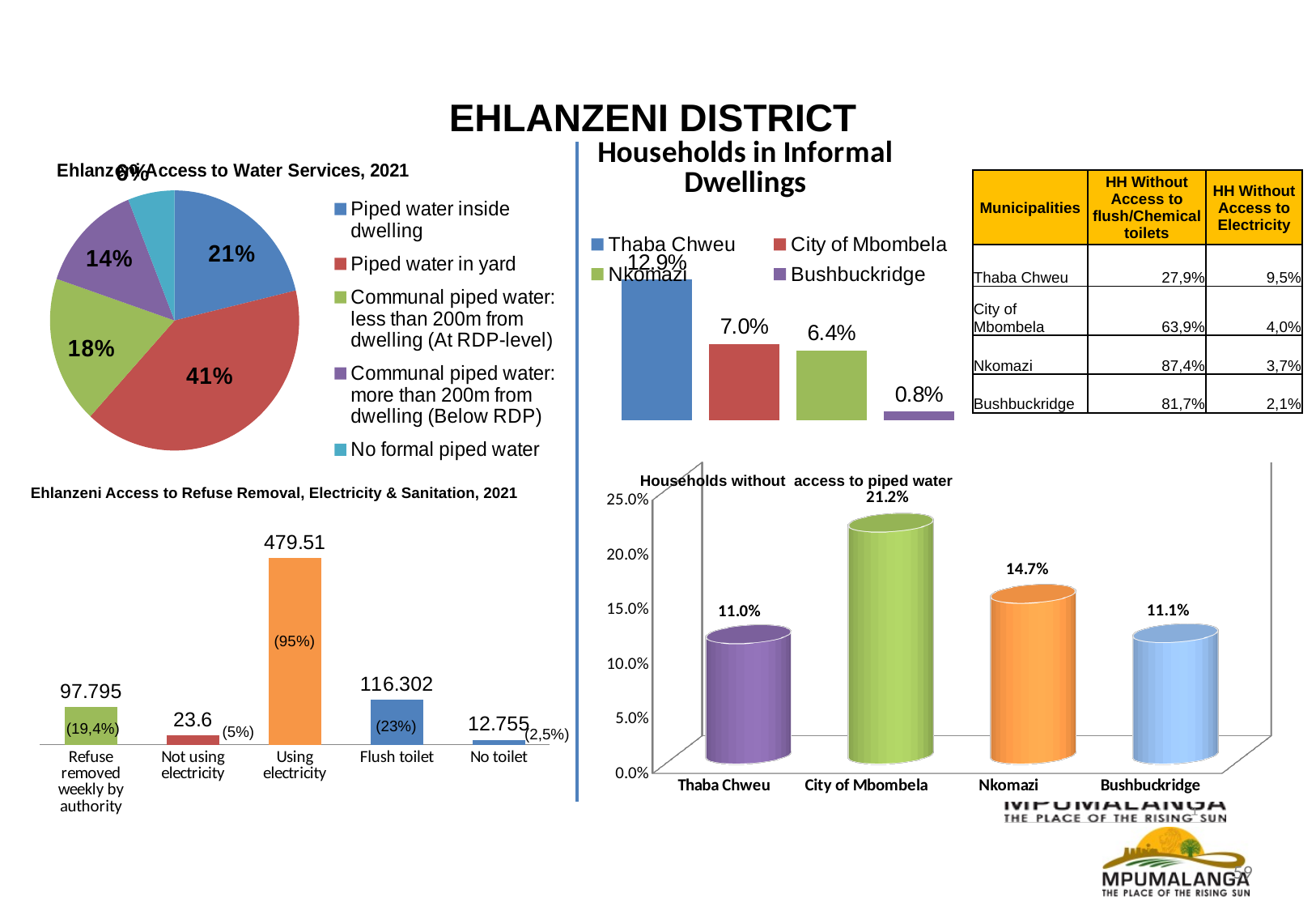
In the 'Ehlanzeni Access to Refuse Removal, Electricity & Sanitation, 2021' chart, what is the value for 'Using electricity'? 479.51 What kind of chart is 'Ehlanzeni Access to Refuse Removal, Electricity & Sanitation, 2021'? Bar chart In the 'Households in Informal Dwellings' chart, which municipality has the lowest value? Bushbuckridge In the 'Households in Informal Dwellings' chart, what is the difference between City of Mbombela and Nkomazi? 0.6% In the 'Ehlanzeni Access to Refuse Removal, Electricity & Sanitation, 2021' chart, which category has the lowest value? No toilet In the 'Households without access to piped water' chart, what is the value for Nkomazi? 14.7% In the 'Ehlanzeni Access to Water Services, 2021' pie chart, what share is 'Piped water in yard'? 41% In the 'Ehlanzeni Access to Water Services, 2021' pie chart, which category has the smallest slice? No formal piped water How many entries does the legend of the 'Ehlanzeni Access to Water Services, 2021' pie chart list? 5 In the 'Ehlanzeni Access to Refuse Removal, Electricity & Sanitation, 2021' chart, how many categories are shown? 5 In the 'Households in Informal Dwellings' chart, what is the value for Thaba Chweu? 12.9% In the 'Households without access to piped water' chart, which municipality has the highest value? City of Mbombela